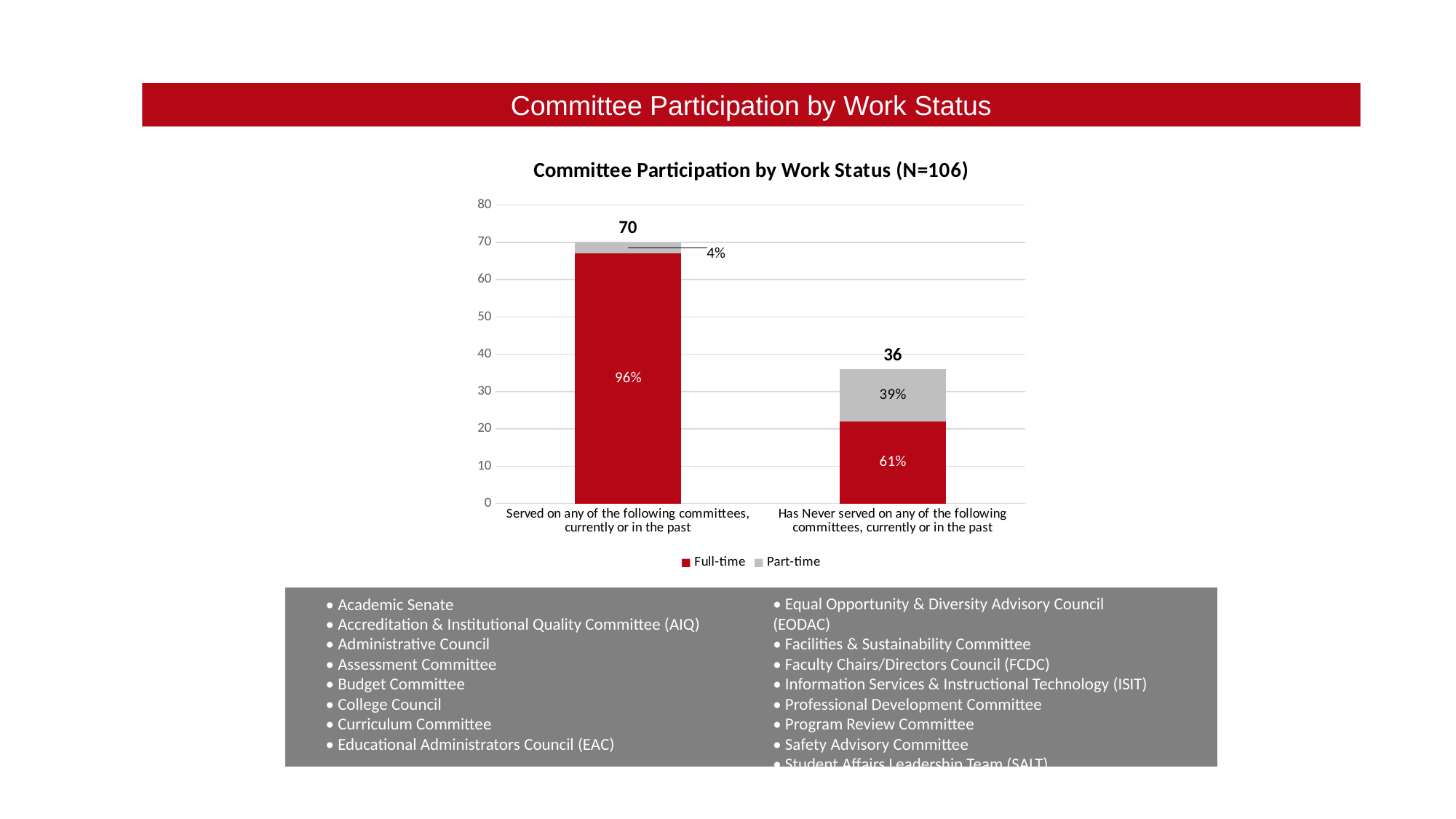
What is the total for the bar 'Served on any of the following committees, currently or in the past'? 70 Which category has the larger total: 'Served on any of the following committees' or 'Has Never served on any of the following committees'? Served on any of the following committees, currently or in the past What kind of chart is shown on the slide? bar chart What percentage label is shown for Part-time in the 'Served on any of the following committees' bar? 4% Is the Full-time segment of the 'Served on any of the following committees' bar greater or less than 60? greater What is the difference between the totals of the two bars? 34 What percentage label is shown for Full-time in the 'Has Never served on any of the following committees' bar? 61% What percentage label is shown for Full-time in the 'Served on any of the following committees' bar? 96% How many series does the legend list? 2 What is the total for the bar 'Has Never served on any of the following committees, currently or in the past'? 36 What percentage label is shown for Part-time in the 'Has Never served on any of the following committees' bar? 39% How many categories are shown on the x axis? 2